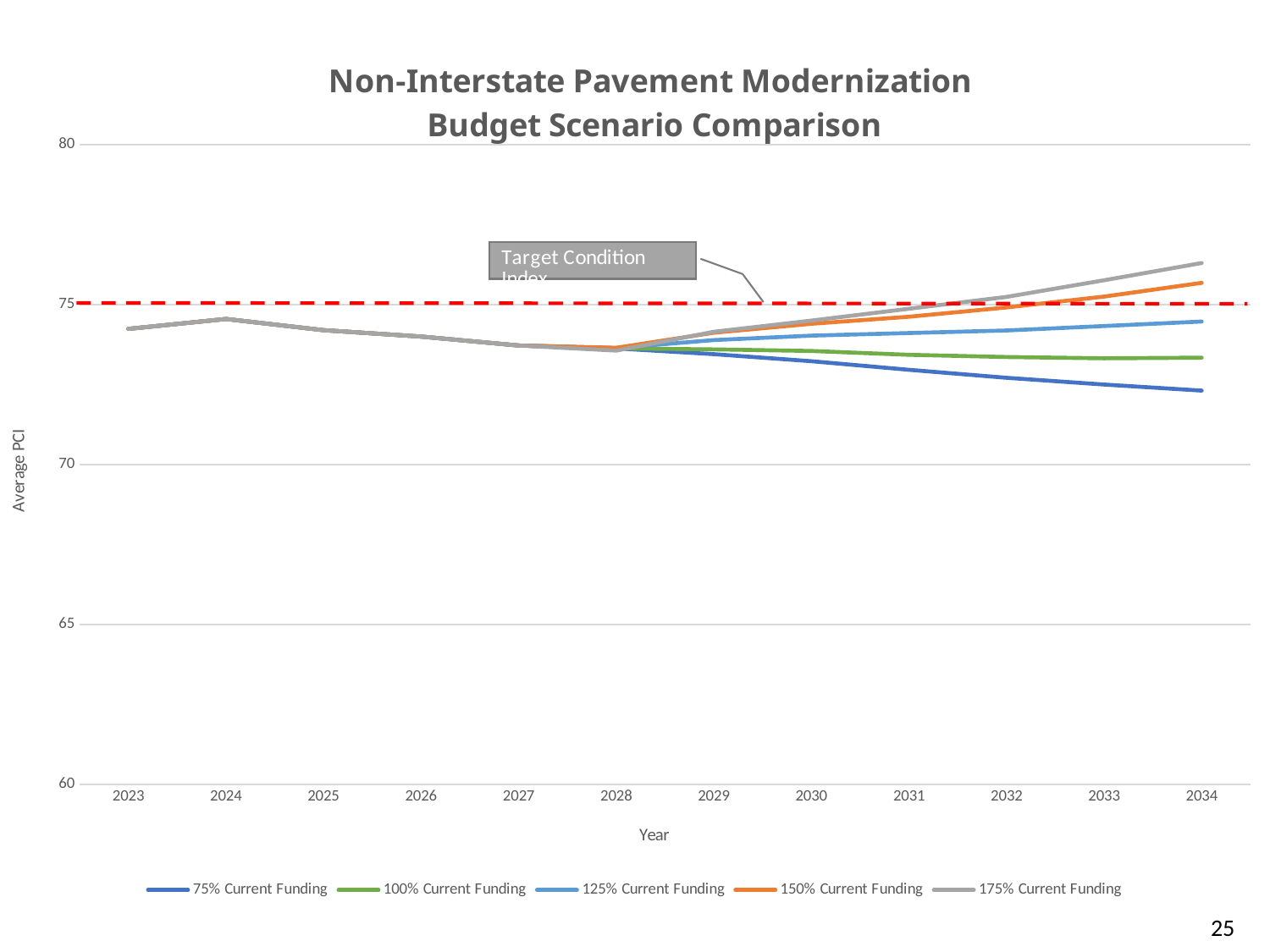
Is the Average PCI for 75% Current Funding in 2034 greater or less than 75? less Which funding scenario has the lowest Average PCI in 2034? 75% Current Funding Which funding scenario has the highest Average PCI in 2034? 175% Current Funding How many years are shown along the x axis? 12 Is the Average PCI for 175% Current Funding in 2034 greater or less than 75? greater Does the Average PCI for 150% Current Funding rise or fall from 2028 to 2034? rise What kind of chart is shown on the slide? line chart In 2034, which is larger: the Average PCI for 150% Current Funding or for 125% Current Funding? 150% Current Funding What Average PCI value does the dashed red Target Condition Index line mark? 75 Does the Average PCI for 75% Current Funding rise or fall from 2028 to 2034? fall How many series does the legend list? 5 Is the Average PCI for 100% Current Funding in 2034 greater or less than 70? greater